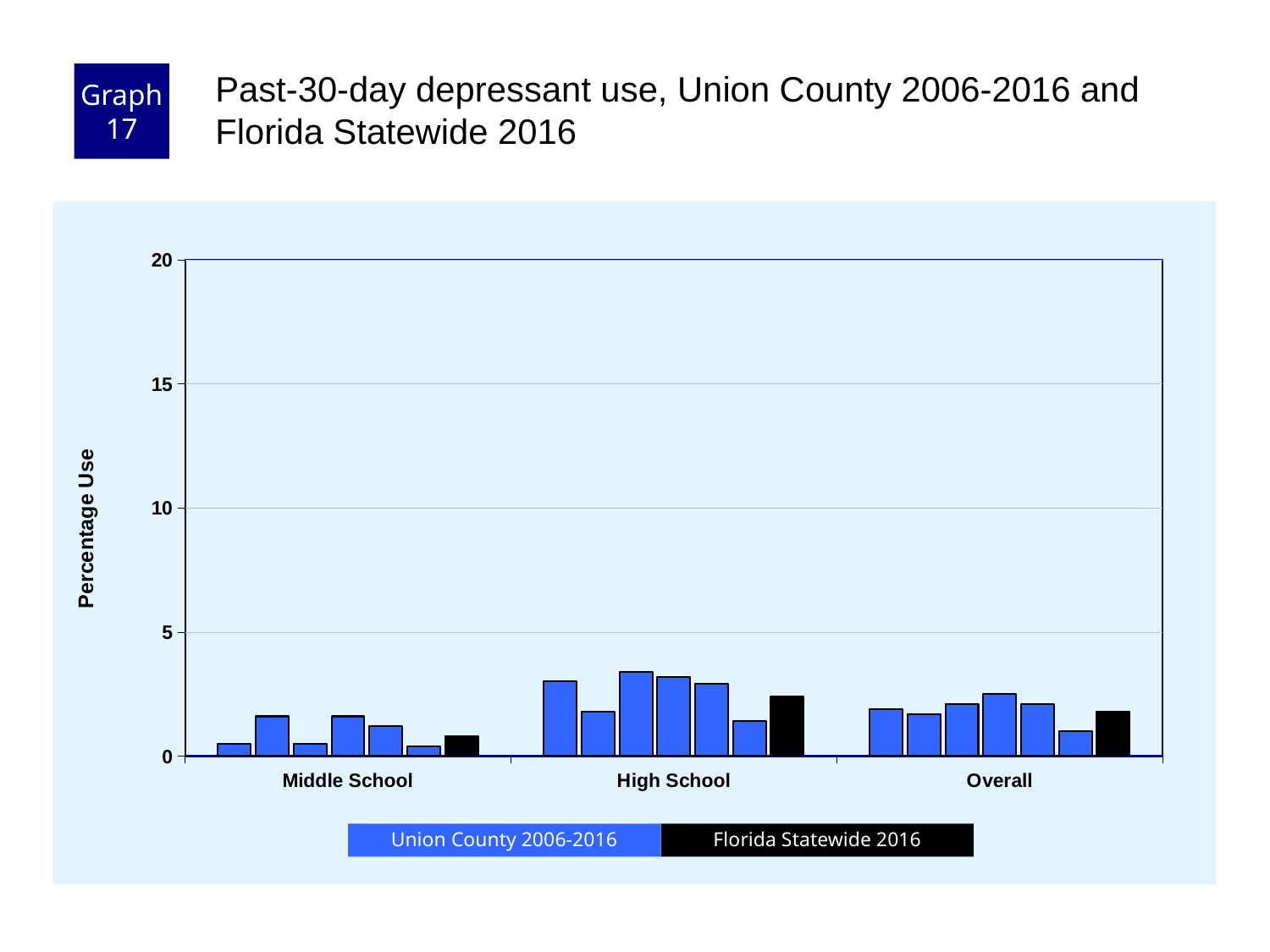
Which colour represents Florida Statewide 2016 in the legend? Black How many series does the legend list? 2 For Florida Statewide 2016, which category has the lowest value? Middle School What kind of chart is shown on the slide? Bar chart Is the Florida Statewide 2016 value for Middle School greater or less than 5? less Which is larger: the Florida Statewide 2016 value for High School or for Middle School? High School For Florida Statewide 2016, which category has the highest value? High School What is the label on the y axis? Percentage Use Is the Florida Statewide 2016 value for High School greater or less than 5? less Which is larger: the Florida Statewide 2016 value for Overall or for Middle School? Overall Are any of the bars on the chart greater than 10? No How many categories are shown along the x axis? 3